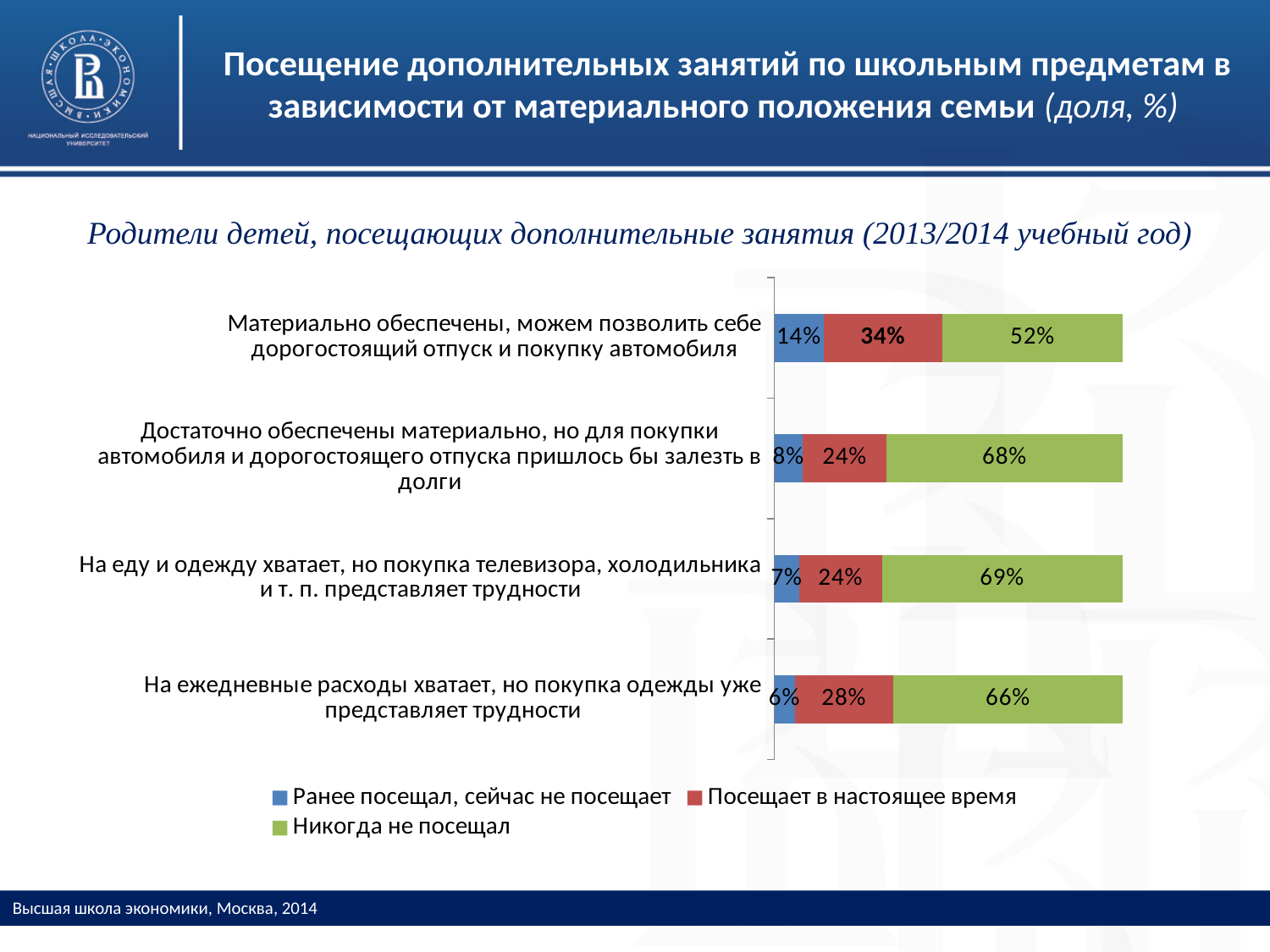
Какова доля «Никогда не посещал» для категории «Достаточно обеспечены материально, но для покупки автомобиля и дорогостоящего отпуска пришлось бы залезть в долги»? 68% Каким цветом на диаграмме обозначен ряд «Никогда не посещал»? Зелёным Сколько рядов данных перечислено в легенде диаграммы? 3 Какова доля «Ранее посещал, сейчас не посещает» для категории «На ежедневные расходы хватает, но покупка одежды уже представляет трудности»? 6% Сколько категорий материального положения семьи показано на диаграмме? 4 Где доля «Посещает в настоящее время» больше: в категории «На ежедневные расходы хватает, но покупка одежды уже представляет трудности» или в категории «На еду и одежду хватает, но покупка телевизора, холодильника и т. п. представляет трудности»? На ежедневные расходы хватает, но покупка одежды уже представляет трудности Какова сумма долей всех трёх рядов для категории «Материально обеспечены, можем позволить себе дорогостоящий отпуск и покупку автомобиля»? 100% В какой категории доля «Ранее посещал, сейчас не посещает» наибольшая? Материально обеспечены, можем позволить себе дорогостоящий отпуск и покупку автомобиля Какой тип диаграммы показан на слайде? Столбчатая диаграмма (горизонтальная, с накоплением) В какой категории доля «Никогда не посещал» наименьшая? Материально обеспечены, можем позволить себе дорогостоящий отпуск и покупку автомобиля На сколько процентных пунктов доля «Никогда не посещал» в категории «На еду и одежду хватает, но покупка телевизора, холодильника и т. п. представляет трудности» больше, чем в категории «Материально обеспечены, можем позволить себе дорогостоящий отпуск и покупку автомобиля»? 17 Какова доля «Посещает в настоящее время» для категории «Материально обеспечены, можем позволить себе дорогостоящий отпуск и покупку автомобиля»? 34%